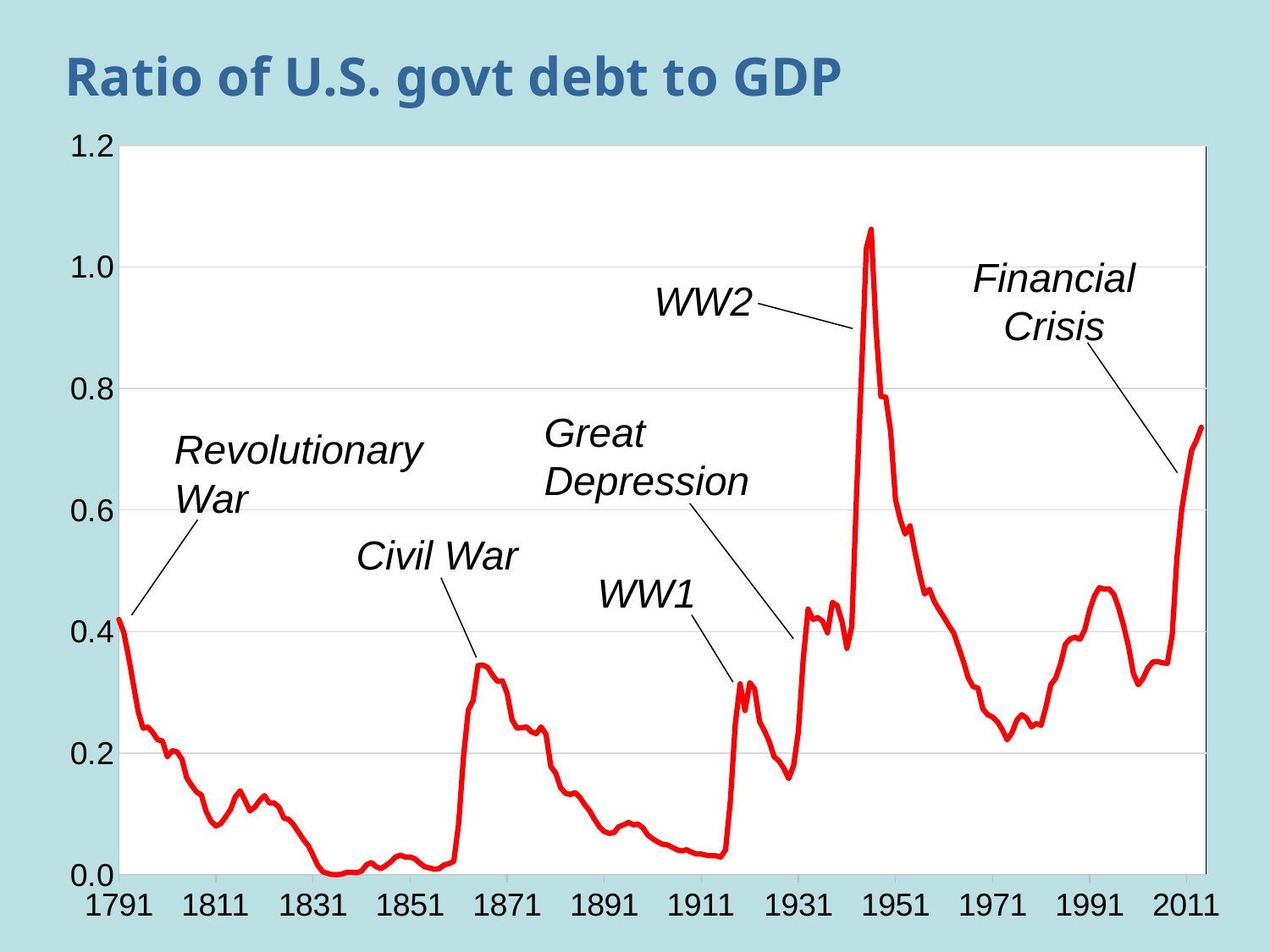
Is the value at the Financial Crisis peak greater or less than 0.6? greater Between 1951 and 1971, does the debt-to-GDP ratio generally rise or fall? fall Which peak is higher, the Financial Crisis peak or the Civil War peak? Financial Crisis Is the peak value at the Civil War greater or less than 0.4? less Which annotated event corresponds to the highest peak in the debt-to-GDP ratio? WW2 Which peak is higher, the WW2 peak or the Financial Crisis peak? WW2 What kind of chart is shown on the slide? line chart Between 1791 and 1831, does the debt-to-GDP ratio generally rise or fall? fall Is the value around 1831 greater or less than 0.2? less What is the title of the chart? Ratio of U.S. govt debt to GDP How many historical events are annotated on the chart? 6